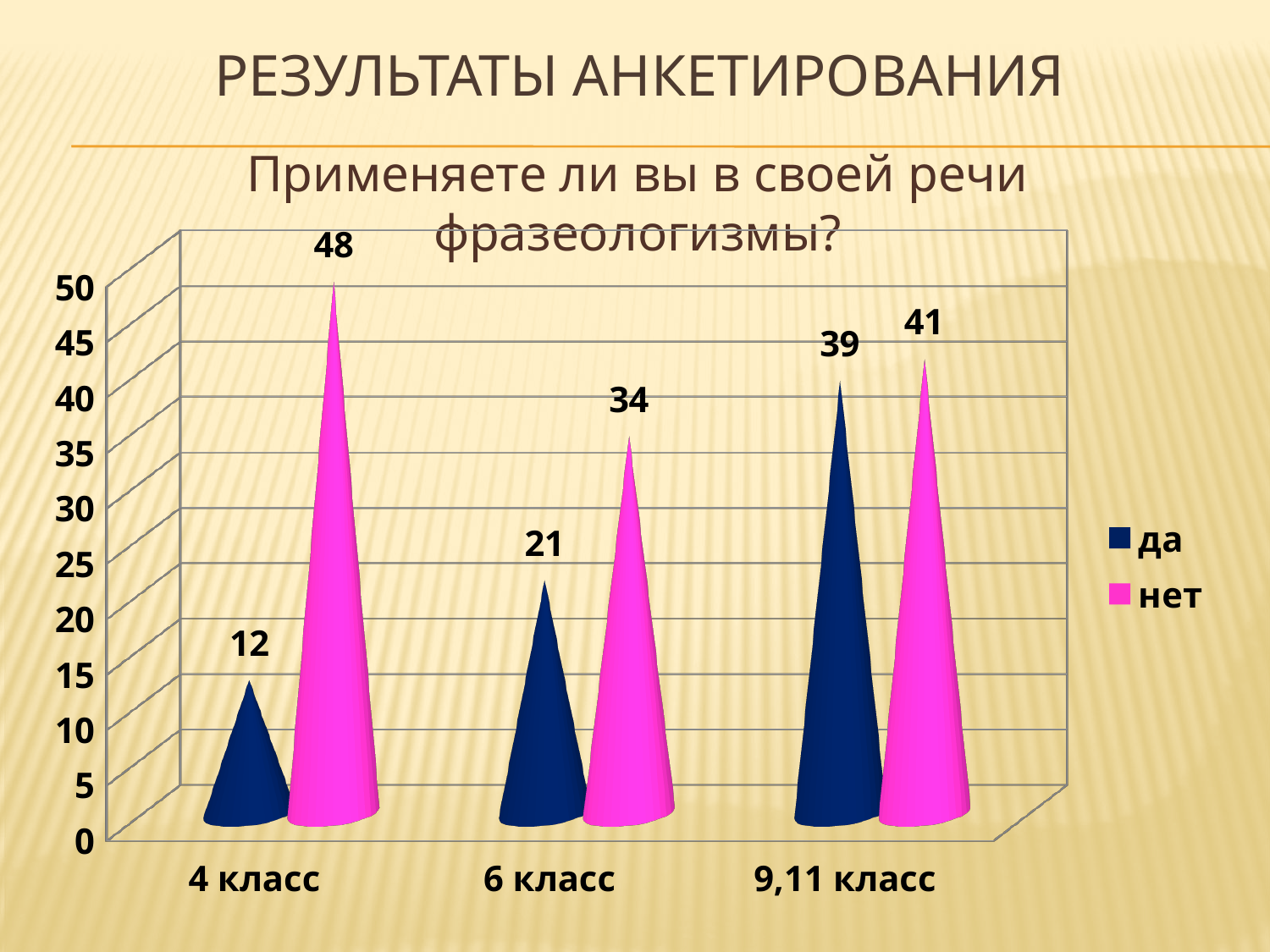
How many categories are shown on the x axis? 3 What colour represents the "нет" series in the legend? pink What kind of chart is shown on the slide? bar chart What is the value for "да" in the "9,11 класс" category? 39 How many series does the legend list? 2 Which category has the lowest value for "да"? 4 класс What is the difference between "нет" and "да" in the "4 класс" category? 36 What is the value for "нет" in the "6 класс" category? 34 Which category has the highest value for "нет"? 4 класс Which is larger in the "6 класс" category, "да" or "нет"? нет What is the value for "да" in the "4 класс" category? 12 Do the values for "да" rise or fall from "4 класс" to "9,11 класс"? rise